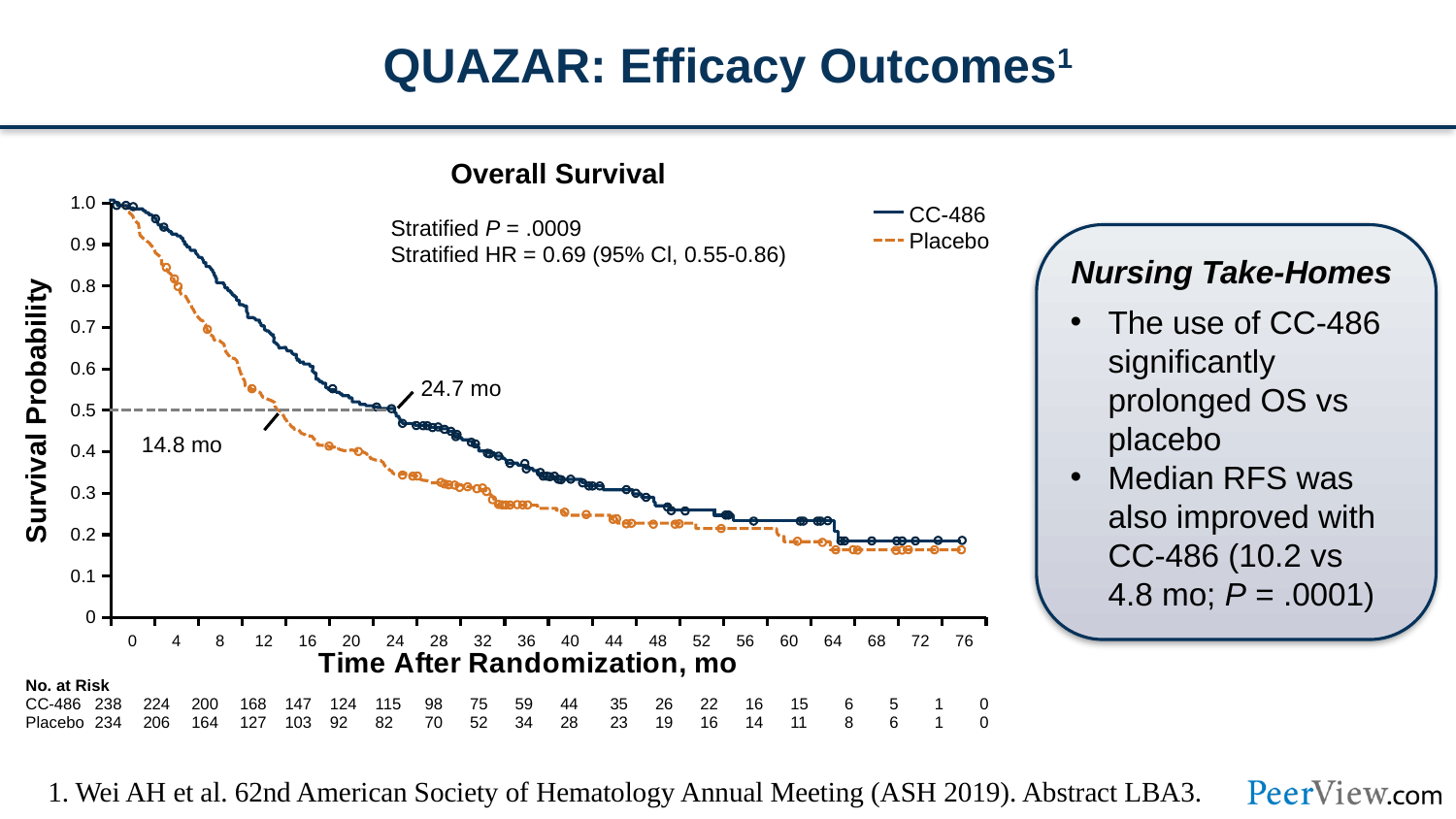
What stratified P value is shown on the Overall Survival chart? .0009 In the Overall Survival chart, what is the median overall survival for the CC-486 arm? 24.7 mo In the Overall Survival chart, what is the median overall survival for the Placebo arm? 14.8 mo How many series does the legend of the Overall Survival chart list? 2 In the Overall Survival chart, which arm has the longer median overall survival, CC-486 or Placebo? CC-486 What kind of chart is the Overall Survival chart? Line chart (Kaplan-Meier survival curve) What stratified hazard ratio is shown on the Overall Survival chart? 0.69 In the No. at Risk table below the Overall Survival chart, how many CC-486 patients were at risk at 24 months? 115 In the Overall Survival chart, what is the difference in median overall survival between CC-486 and Placebo? 9.9 mo In the Overall Survival chart, do the survival probability curves rise or fall as time after randomization increases? Fall In the Overall Survival chart, is the survival probability for Placebo at 40 months greater or less than 0.3? less In the Overall Survival chart, which series is drawn with a dashed line? Placebo